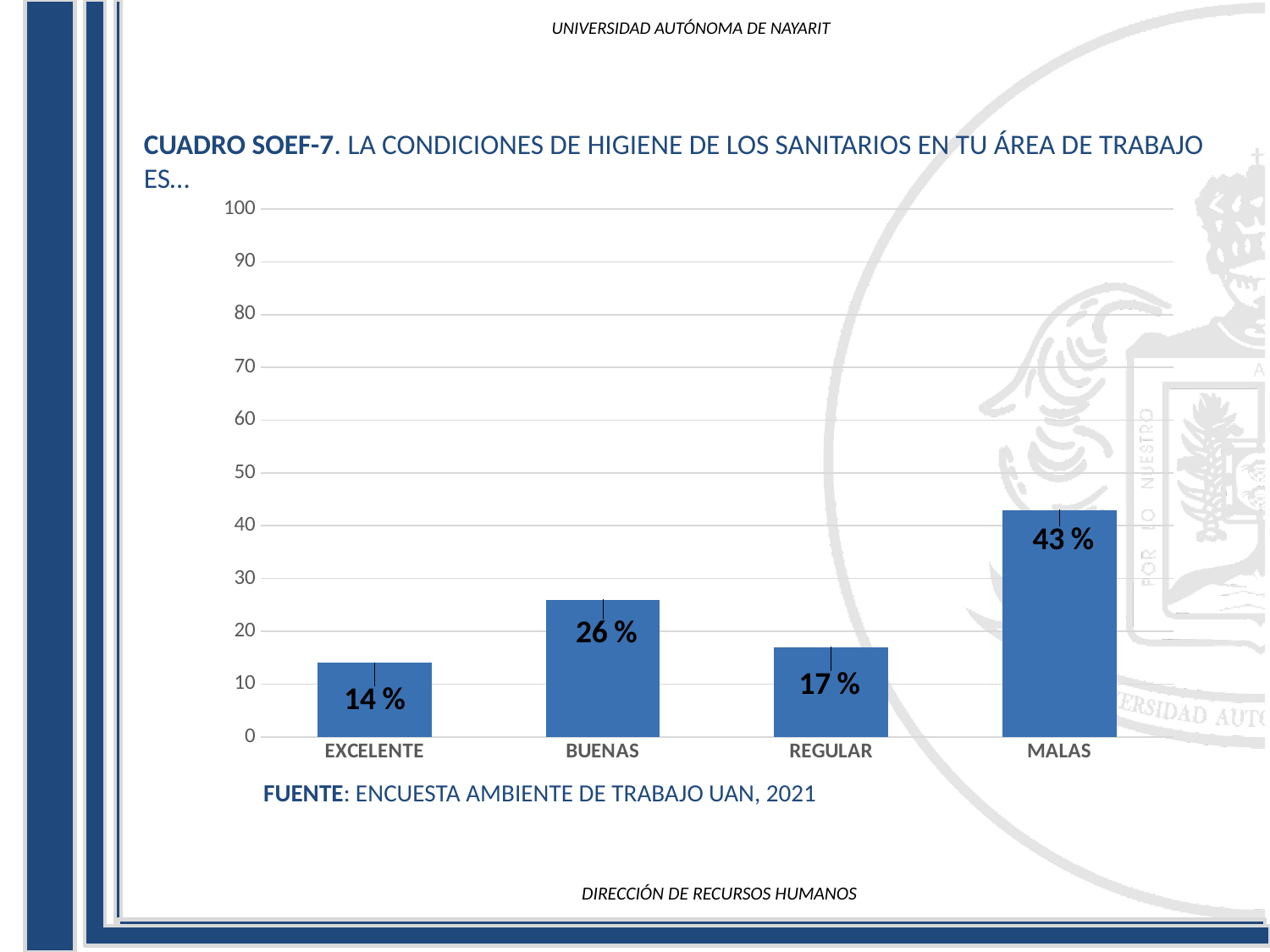
How many categories are shown on the x axis? 4 What kind of chart is shown on the slide? bar chart Is the value for MALAS greater or less than 40? greater Which is larger, the value for BUENAS or the value for REGULAR? BUENAS What is the value for REGULAR? 17 % Which category has the highest value? MALAS What is the value for EXCELENTE? 14 % Which category has the lowest value? EXCELENTE What is the value for MALAS? 43 % What is the source cited below the chart? ENCUESTA AMBIENTE DE TRABAJO UAN, 2021 What is the value for BUENAS? 26 % What is the difference between the values for MALAS and BUENAS? 17 %